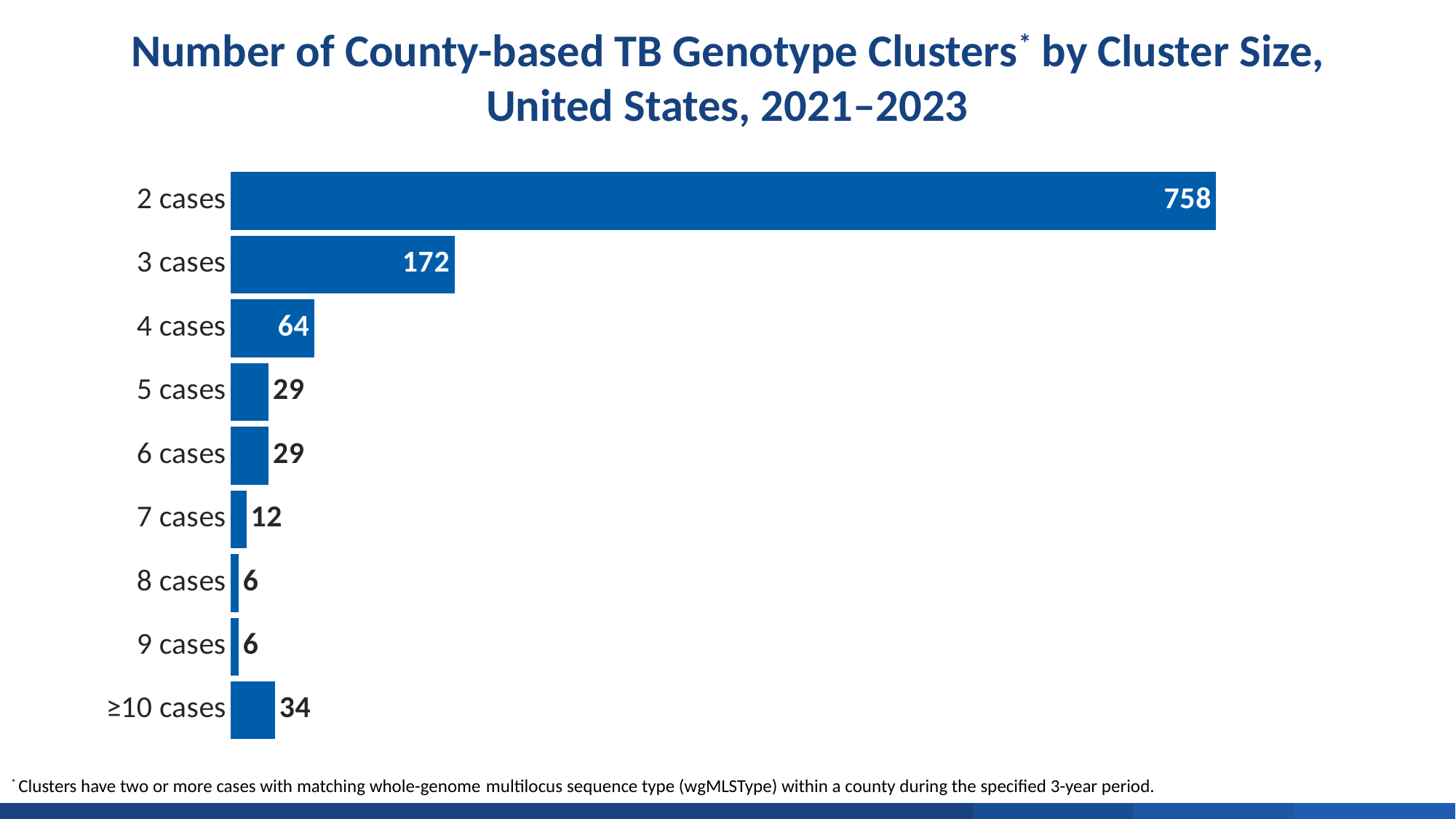
What is the title of the chart? Number of County-based TB Genotype Clusters by Cluster Size, United States, 2021–2023 How many county-based TB genotype clusters had 2 cases? 758 What is the value shown for clusters with 7 cases? 12 What type of chart is shown on the slide? Bar chart How many cluster size categories are shown in the chart? 9 Do the values generally rise or fall as cluster size increases from 2 cases to 9 cases? Fall What is the difference between the number of clusters with 4 cases and the number with 5 cases? 35 Which cluster size has the highest number of clusters? 2 cases Which is larger: the number of clusters with ≥10 cases or the number with 6 cases? ≥10 cases What is the difference between the number of clusters with 2 cases and the number with 3 cases? 586 How many clusters had ≥10 cases? 34 What is the number of clusters with 3 cases? 172